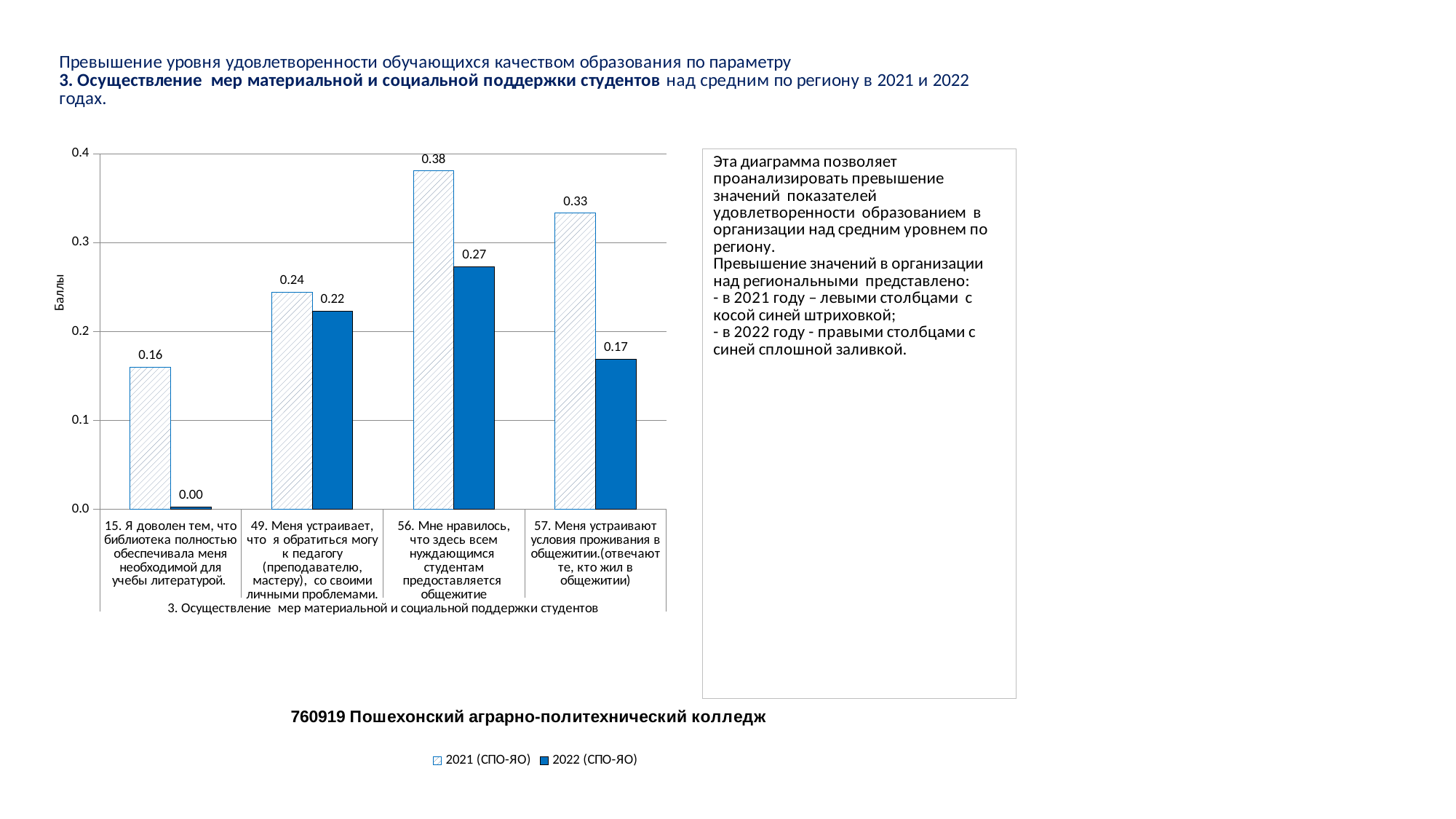
What type of chart is shown on the slide? Bar chart What is the value for 2021 (СПО-ЯО) for category 15 ("Я доволен тем, что библиотека полностью обеспечивала меня необходимой для учебы литературой")? 0.16 What is the label of the vertical axis of the chart? Баллы How many categories are shown on the x axis of the chart? 4 For category 49 ("Меня устраивает, что я обратиться могу к педагогу..."), which series has the larger value, 2021 (СПО-ЯО) or 2022 (СПО-ЯО)? 2021 (СПО-ЯО) How many series does the chart legend list? 2 Which category has the highest value for 2021 (СПО-ЯО)? 56. Мне нравилось, что здесь всем нуждающимся студентам предоставляется общежитие Which category has the lowest value for 2022 (СПО-ЯО)? 15. Я доволен тем, что библиотека полностью обеспечивала меня необходимой для учебы литературой What is the difference between the 2021 (СПО-ЯО) and 2022 (СПО-ЯО) values for category 57 ("Меня устраивают условия проживания в общежитии")? 0.16 What is the value for 2022 (СПО-ЯО) for category 56 ("Мне нравилось, что здесь всем нуждающимся студентам предоставляется общежитие")? 0.27 What is the difference between the 2021 (СПО-ЯО) values for category 56 and category 15? 0.22 What is the value for 2022 (СПО-ЯО) for category 15 ("Я доволен тем, что библиотека полностью обеспечивала меня необходимой для учебы литературой")? 0.00